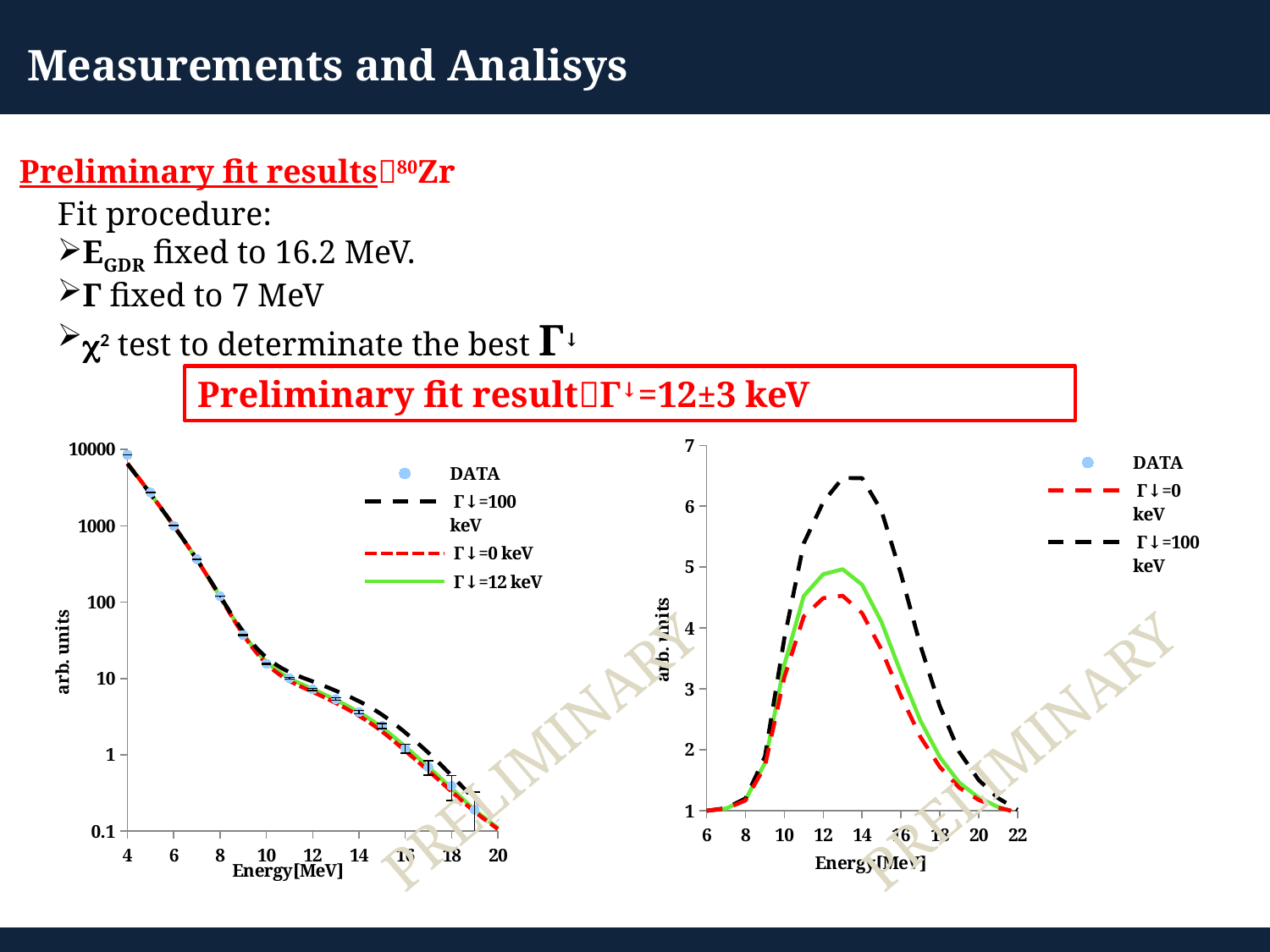
In the left chart, do the values rise or fall as energy increases along the x axis? fall In the left chart, is the DATA value at 10 MeV greater or less than 10? greater What kind of chart is the left chart on the slide? line chart What is the y-axis label of the left chart? arb. units In the right chart, which curve reaches the higher peak, Γ↓=100 keV or Γ↓=0 keV? Γ↓=100 keV How many series does the legend of the right chart list? 3 In the right chart, is the peak of the Γ↓=0 keV curve greater or less than 5? less What is the x-axis label of the right chart? Energy[MeV] In the right chart, is the peak of the Γ↓=100 keV curve greater or less than 6? greater How many series does the legend of the left chart list? 4